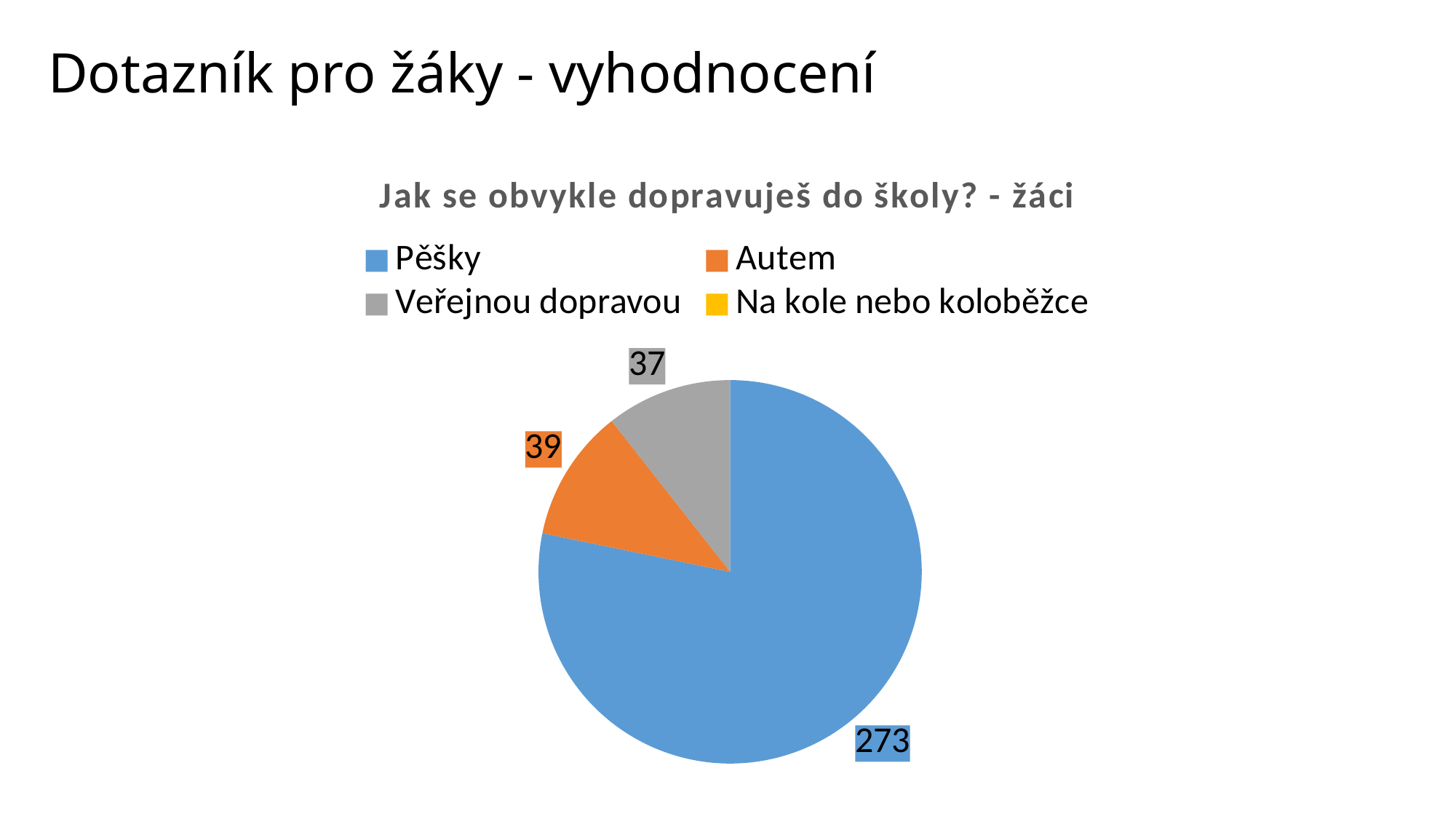
What is the difference between the value for Autem and the value for Veřejnou dopravou? 2 What is the difference between the value for Pěšky and the value for Autem? 234 What is the title of the chart? Jak se obvykle dopravuješ do školy? - žáci Which is larger, the value for Autem or the value for Veřejnou dopravou? Autem What is the value for Pěšky? 273 Which category has the largest slice of the pie? Pěšky What colour is the slice for Pěšky? blue What is the value for Autem? 39 What kind of chart is shown on the slide? pie chart What is the value for Veřejnou dopravou? 37 How many categories does the legend list? 4